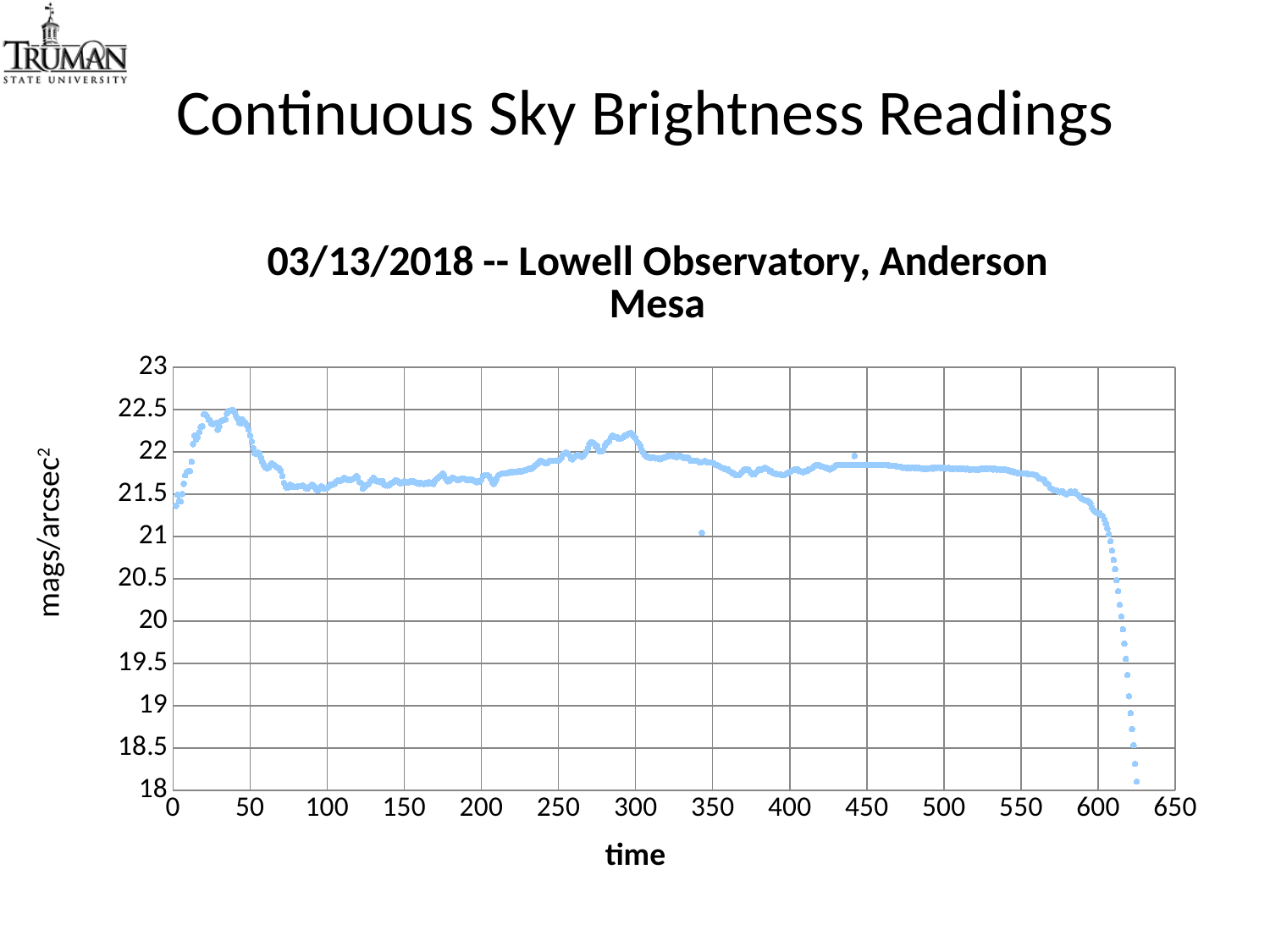
Do the values rise or fall between time 0 and time 40? rise Is the isolated point near time 340 greater or less than 21.5? less What is the label of the x axis of the chart? time Is the value at time 450 greater or less than 21.5? greater Is the highest plotted value near time 40 or near time 300? near time 40 What kind of chart is shown on the slide? scatter chart Is the value at time 40 greater or less than 22? greater Do the values rise or fall after time 600? fall What is the title of the chart? 03/13/2018 -- Lowell Observatory, Anderson Mesa Is the lowest plotted value at the start or the end of the time axis? end